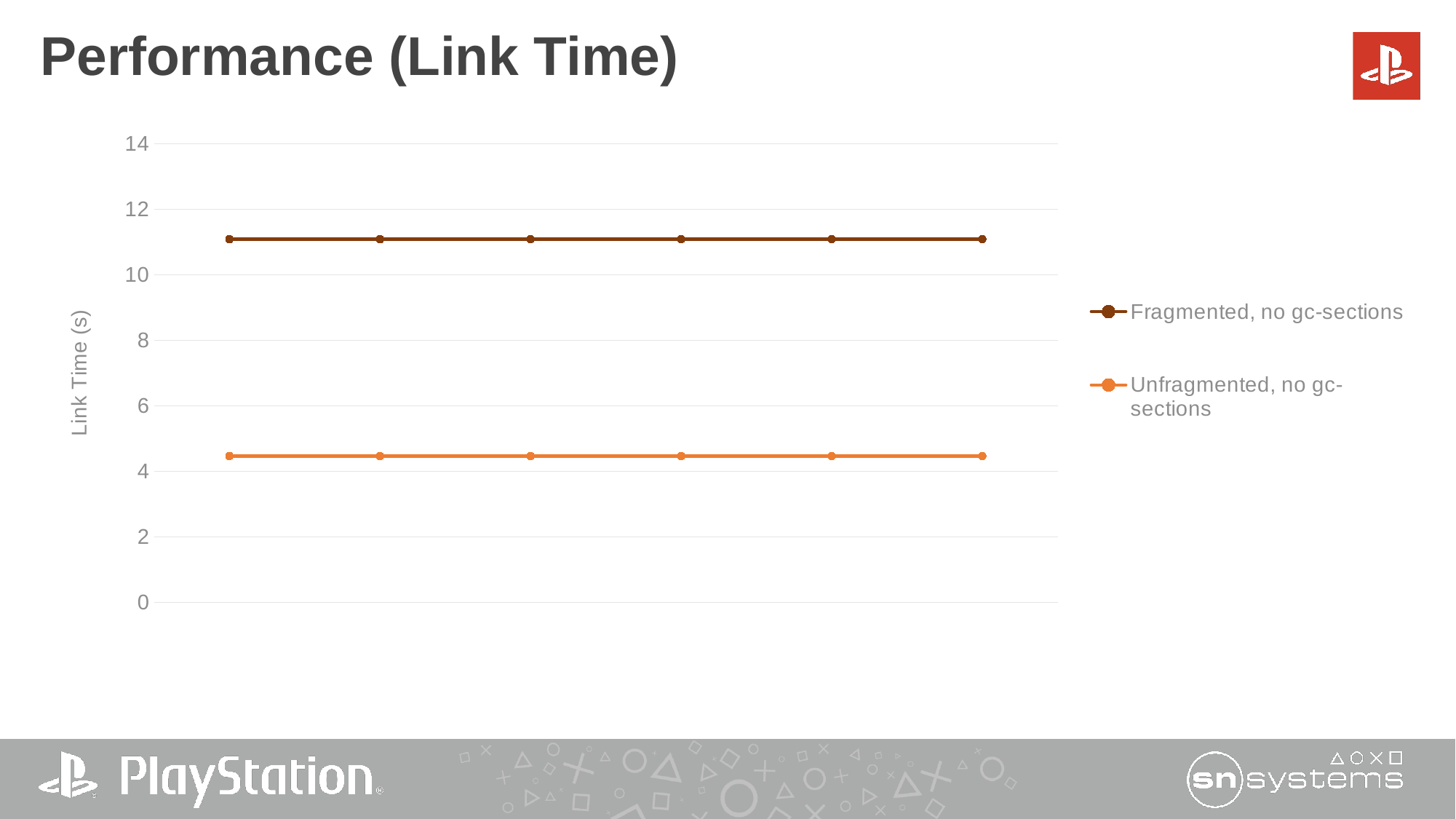
What kind of chart is shown on the slide? line chart Is the value for Unfragmented, no gc-sections greater or less than 6? less How many data points are plotted for the Fragmented, no gc-sections series? 6 What is the title of the slide containing the chart? Performance (Link Time) Is the value for Fragmented, no gc-sections greater or less than 10? greater Which series has the higher link time, Fragmented, no gc-sections or Unfragmented, no gc-sections? Fragmented, no gc-sections Which series has the lowest link time? Unfragmented, no gc-sections Is the value for Unfragmented, no gc-sections greater or less than 4? greater What is the label on the vertical axis? Link Time (s) Do the values for Fragmented, no gc-sections rise, fall, or stay flat along the x axis? stay flat How many series does the legend list? 2